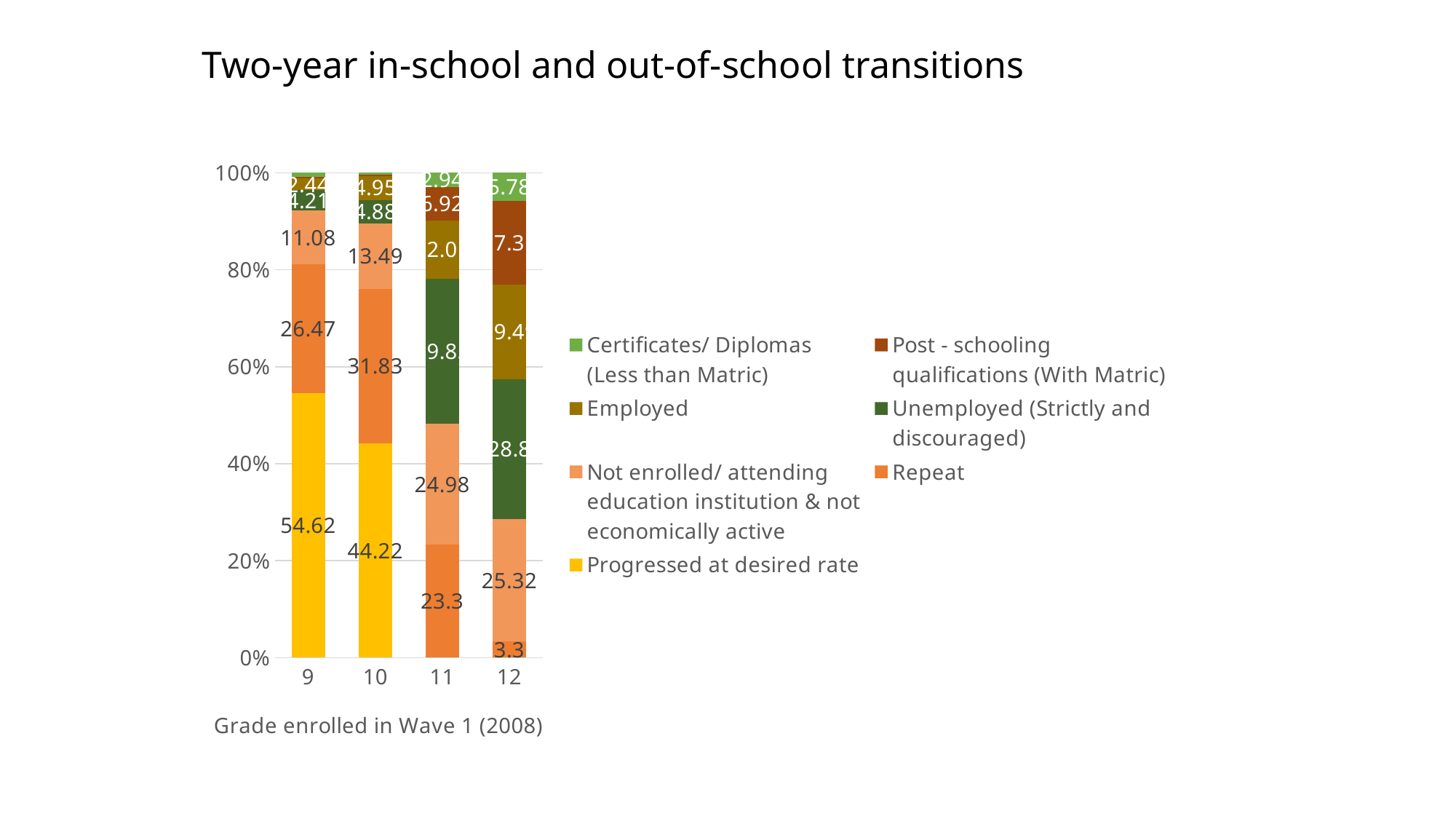
How many series does the legend list? 7 What is the Certificates/ Diplomas (Less than Matric) value for grade 12? 5.78 What is the difference between the Progressed at desired rate values for grade 9 and grade 10? 10.4 Which grade has the highest value for Progressed at desired rate? 9 What is the value for Progressed at desired rate for grade 9? 54.62 What is the Repeat value for grade 10? 31.83 What is the Repeat value for grade 12? 3.3 Which grade has the larger Not enrolled/ attending education institution & not economically active value, grade 11 or grade 12? 12 Which grade has the highest Repeat value? 10 What is the value for Not enrolled/ attending education institution & not economically active for grade 11? 24.98 How many grades are shown on the x axis? 4 What is the difference between the Repeat values for grade 10 and grade 9? 5.36